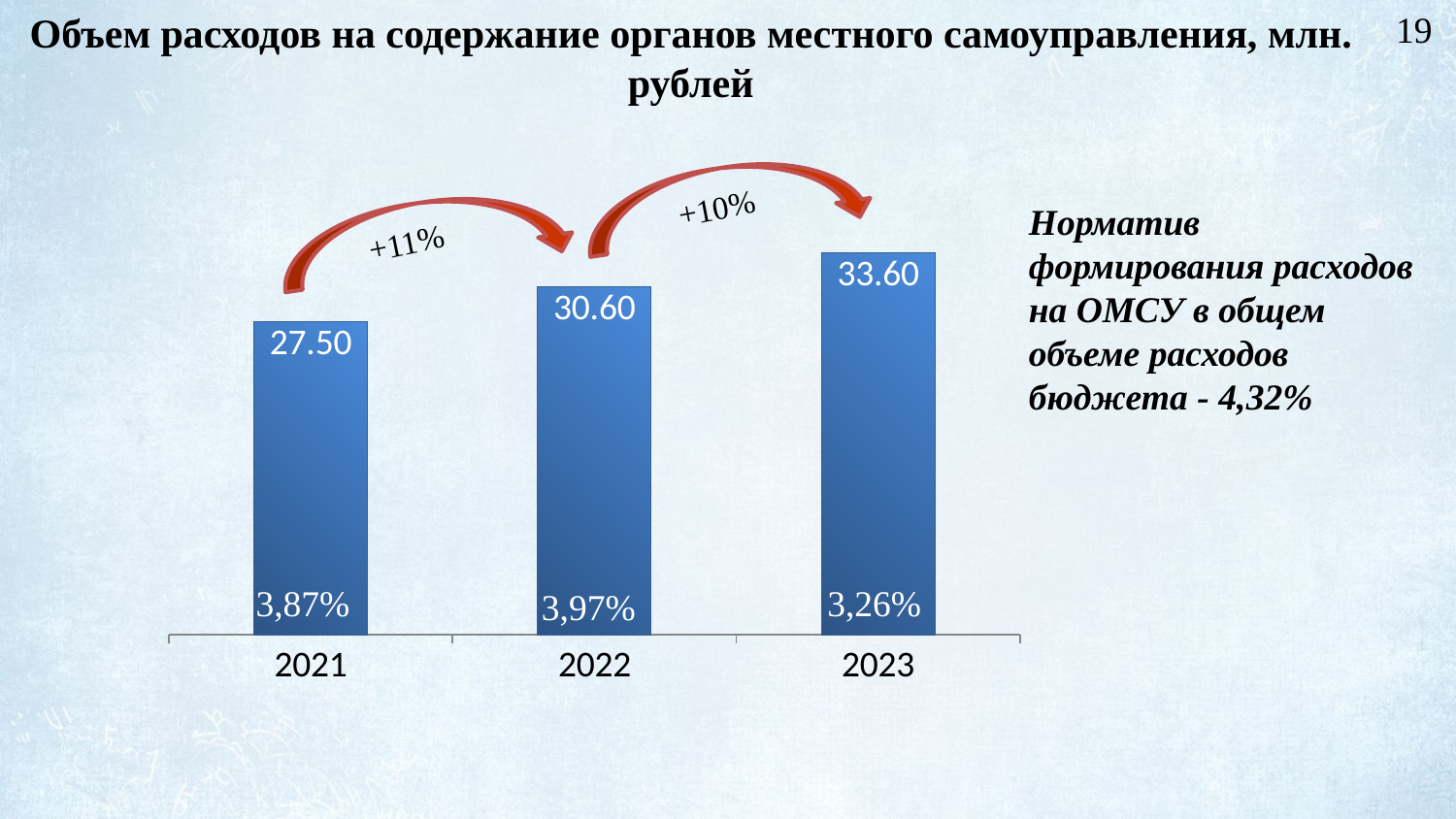
What is the value for 2022? 30.60 What is the value for 2023? 33.60 What percentage is printed at the bottom of the 2022 bar? 3,97% Do the values rise or fall from 2021 to 2023? rise What is the difference between the values for 2023 and 2021? 6.10 What kind of chart is this? bar chart Which year has the highest value? 2023 What is the difference between the values for 2022 and 2021? 3.10 How many years are shown on the x axis? 3 Which is larger, the value for 2022 or the value for 2023? 2023 Which year has the lowest value? 2021 What is the value for 2021? 27.50